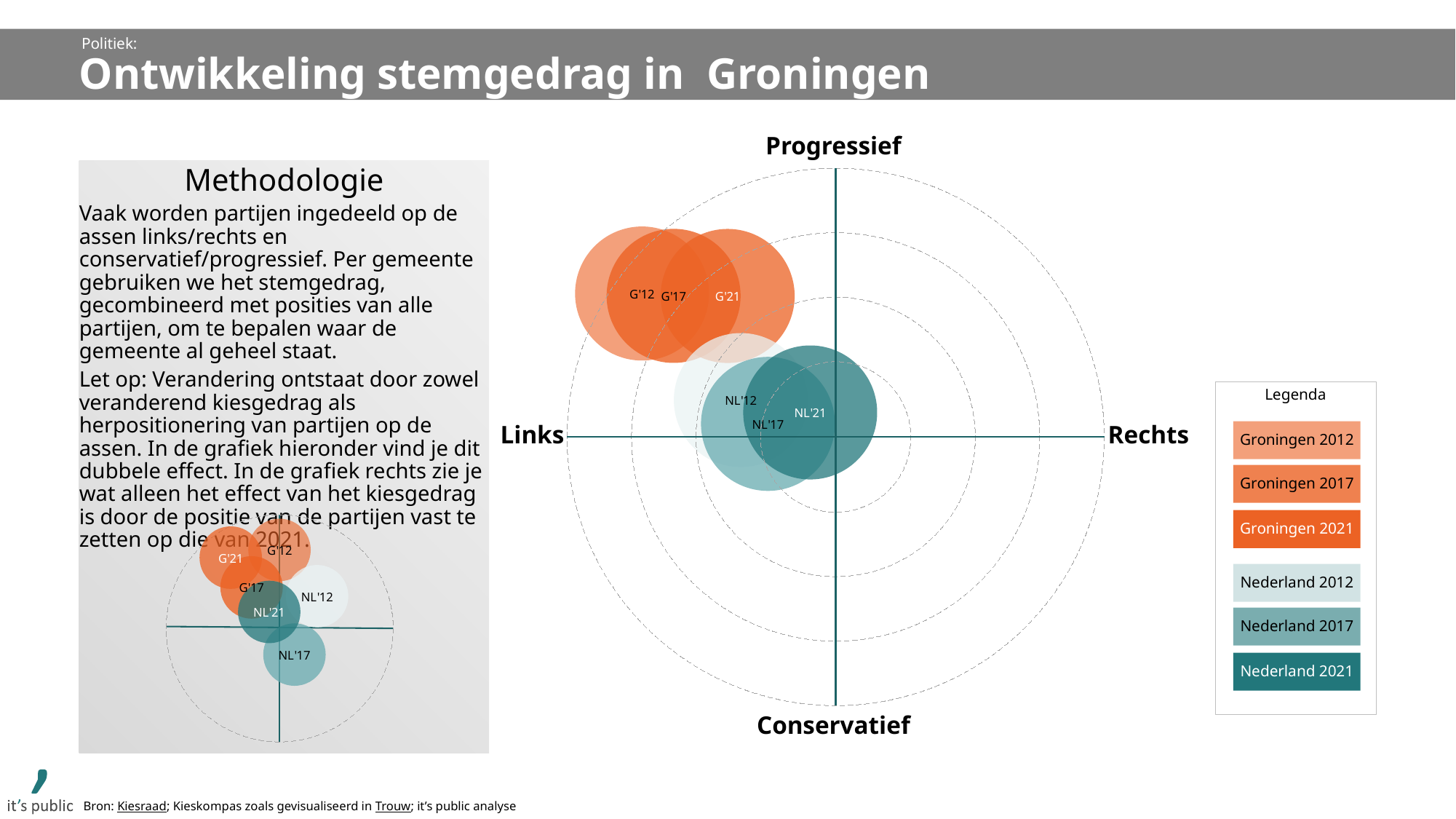
In the large central chart, which is positioned further to the right: G'21 or G'12? G'21 In the large central chart, which is positioned more towards 'Progressief': G'12 or NL'12? G'12 Which legend entry is shown in the darkest teal colour? Nederland 2021 In the small chart at the bottom left, which bubble lies lowest (most 'Conservatief')? NL'17 In the small chart at the bottom left, which is positioned further to the right: NL'12 or G'21? NL'12 How many labelled bubbles are plotted in the large central chart? 6 In the large central chart, in which quadrant do the Groningen bubbles (G'12, G'17, G'21) lie? Links / Progressief What label appears at the top of the vertical axis of the large central chart? Progressief How many entries does the legend (Legenda) list? 6 What kind of chart is the large chart in the centre of the slide? bubble chart In the large central chart, which bubble lies furthest to the left (most 'Links')? G'12 In the large central chart, which bubble lies furthest to the right (most 'Rechts')? NL'21